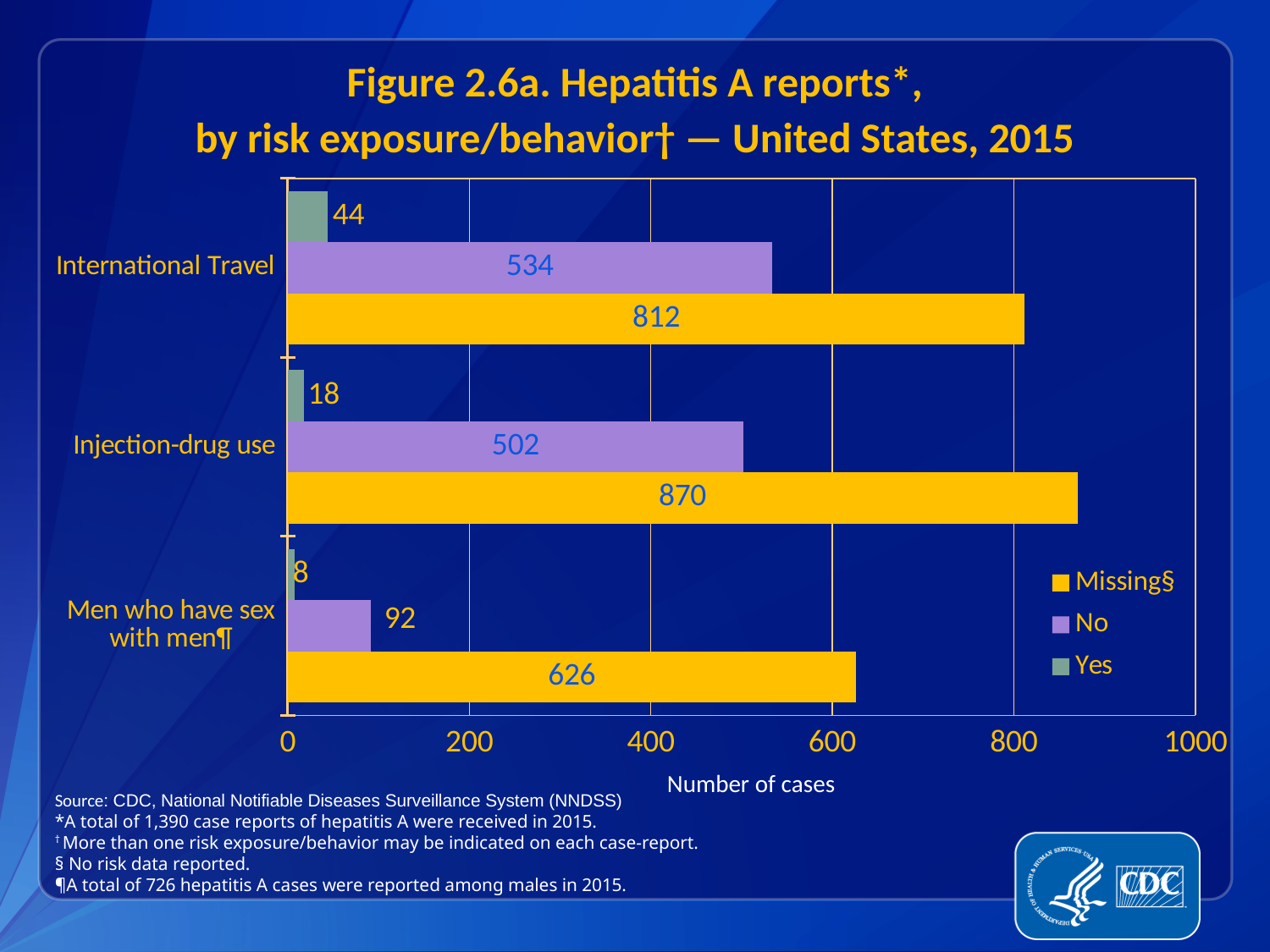
Which risk exposure/behavior has the lowest 'Yes' value? Men who have sex with men Which risk exposure/behavior has the highest 'Missing' value? Injection-drug use Is the 'No' value for Injection-drug use greater or less than 400? greater What is the number of cases with 'No' for Men who have sex with men? 92 What is the number of cases with 'Missing' for Injection-drug use? 870 What kind of chart is shown on the slide? Bar chart What is the difference between the 'No' values for International Travel and Injection-drug use? 32 Which is larger: the 'Missing' value for International Travel or the 'Missing' value for Men who have sex with men? International Travel What is the label of the x axis? Number of cases What is the number of cases with 'Yes' for International Travel? 44 How many risk exposure/behavior categories are shown on the chart? 3 How many series does the legend list? 3